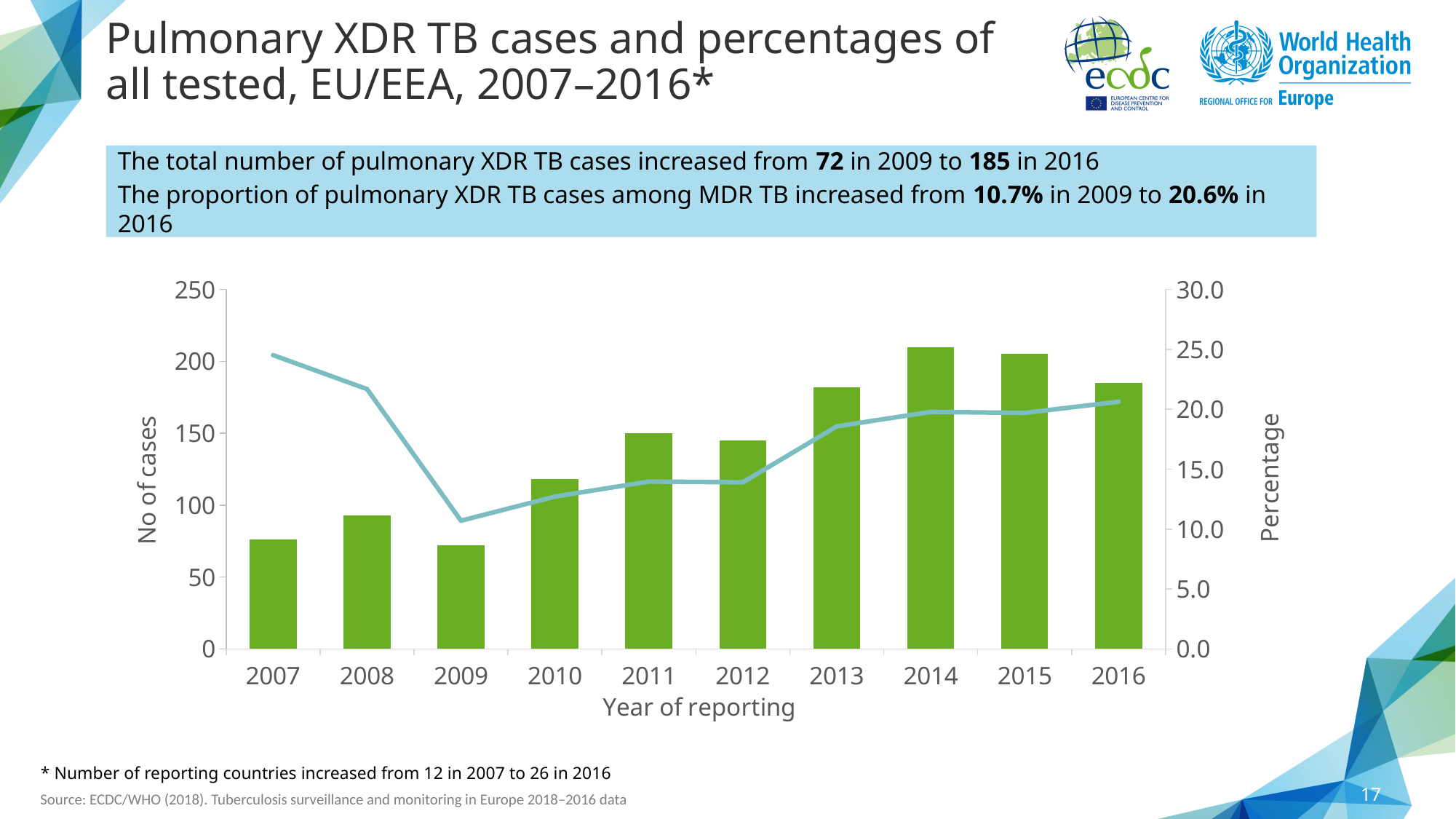
Which year has the highest percentage value on the line? 2007 How many years of reporting are shown on the x axis? 10 Which year has the lowest percentage value on the line? 2009 What was the proportion of pulmonary XDR TB cases among MDR TB in 2016? 20.6% Is the number of cases for 2013 greater or less than 150? greater What was the total number of pulmonary XDR TB cases in 2016? 185 What is the label of the right-hand vertical axis? Percentage What was the total number of pulmonary XDR TB cases in 2009? 72 Is the number of cases for 2008 greater or less than 100? less By how much did the number of pulmonary XDR TB cases increase from 2009 to 2016? 113 Does the percentage line rise or fall from 2009 to 2016? rise Which year has more cases, 2012 or 2013? 2013